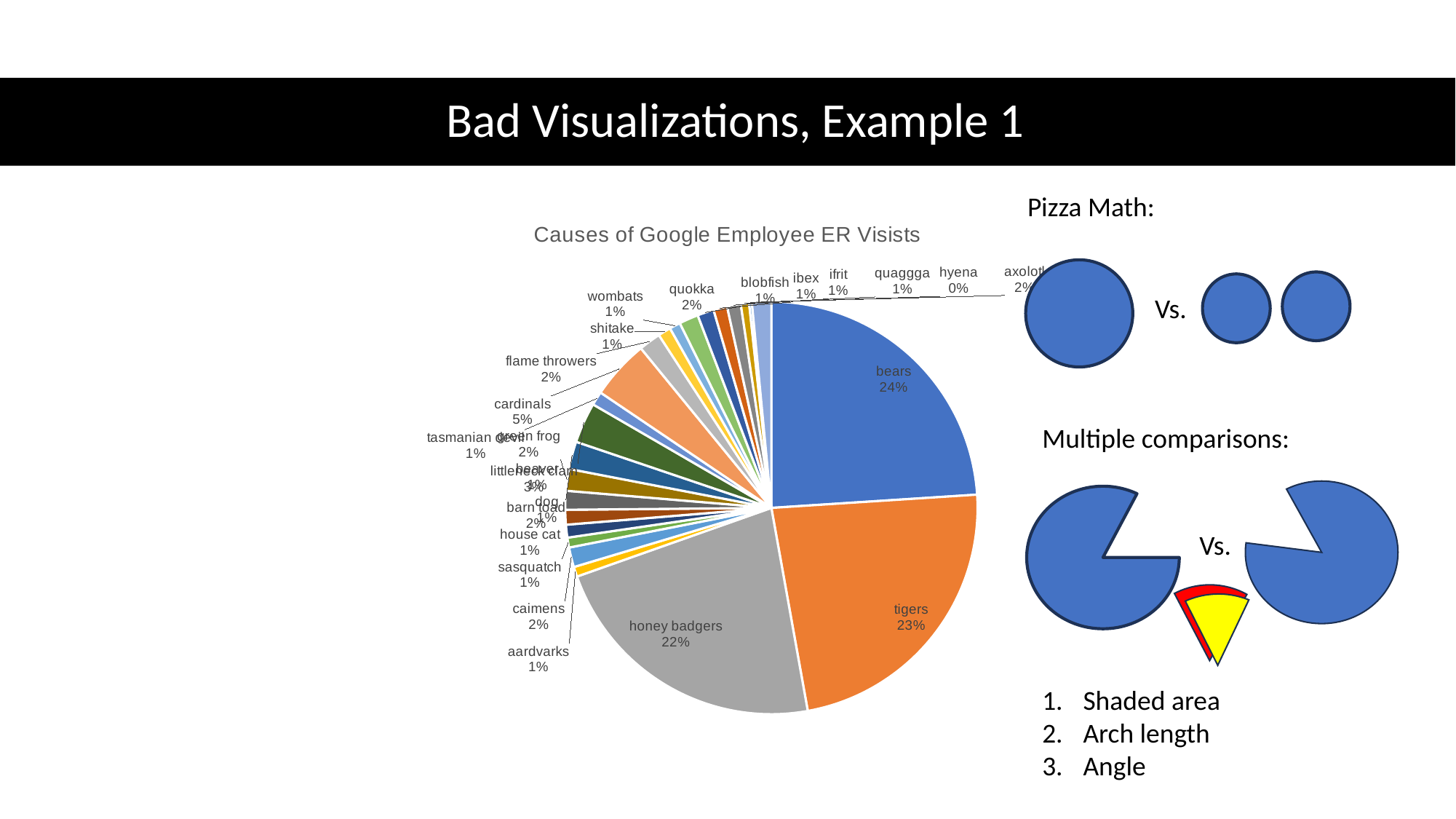
What share of the pie does the tigers slice represent? 23% What is the difference in percentage points between bears and honey badgers? 2 What percentage is shown for flame throwers? 2% Which category has the largest slice of the pie? bears Which category is labelled with 0%? hyena What kind of chart is shown on the slide? pie chart What percentage is shown for quokka? 2% What share of the pie does the honey badgers slice represent? 22% What is the title of the pie chart? Causes of Google Employee ER Visists Which slice is larger, tigers or cardinals? tigers What share of the pie does the bears slice represent? 24% What percentage is shown for cardinals? 5%